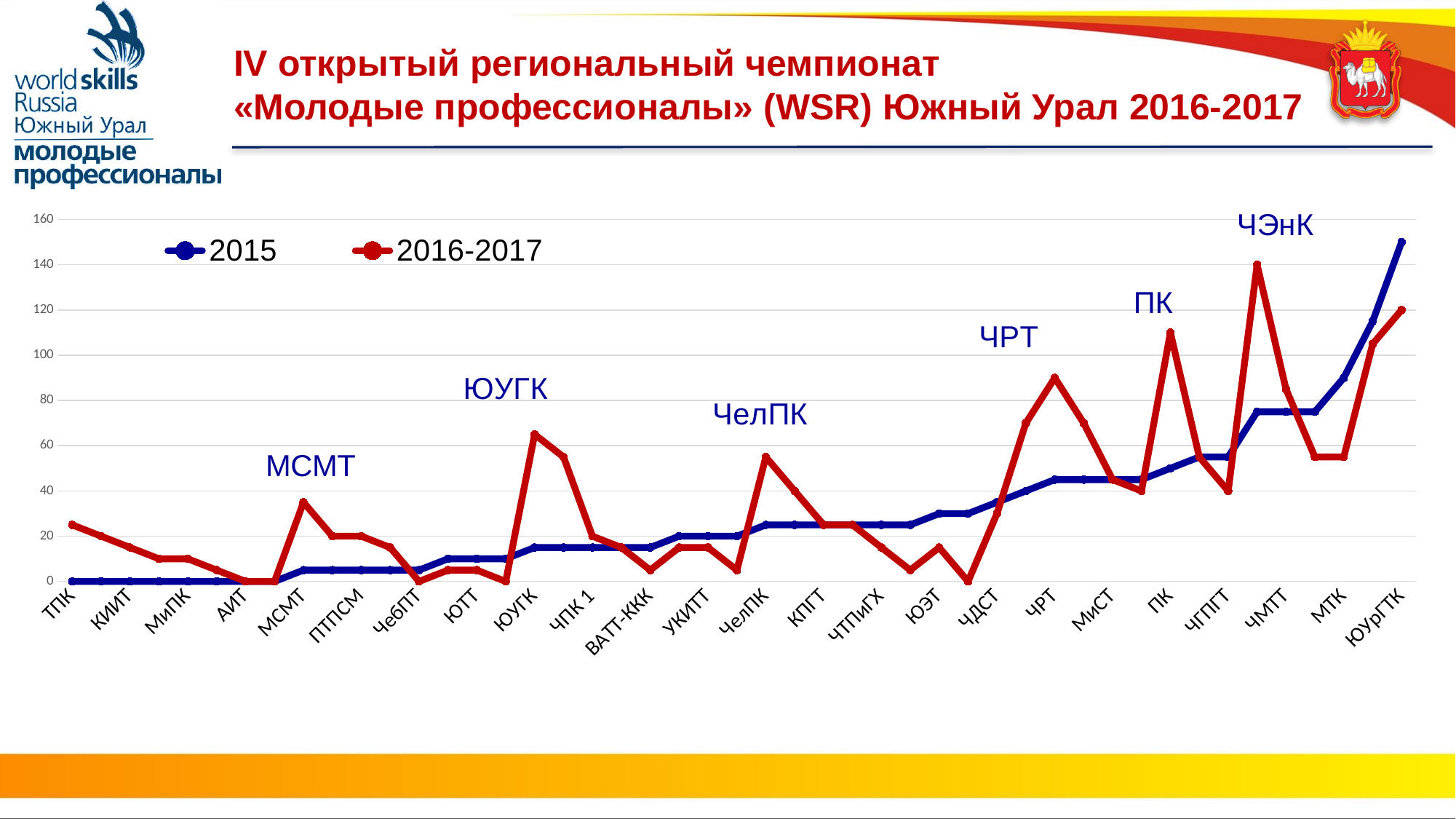
What is the 2016-2017 value for ЮУрГТК? 120 Which category has the highest value for the 2015 series? ЮУрГТК Is the 2015 value for ПК greater or less than 60? less What is the 2015 value for ТПК? 0 Is the 2016-2017 value for ЧРТ greater or less than 80? greater What are the two series named in the legend? 2015 and 2016-2017 How many series does the legend list? 2 What kind of chart is shown on the slide? line chart Does the 2015 series generally rise or fall from left to right along the x axis? rise Is the 2015 value for ЮУрГТК greater or less than 140? greater For ЮУрГТК, which series has the larger value, 2015 or 2016-2017? 2015